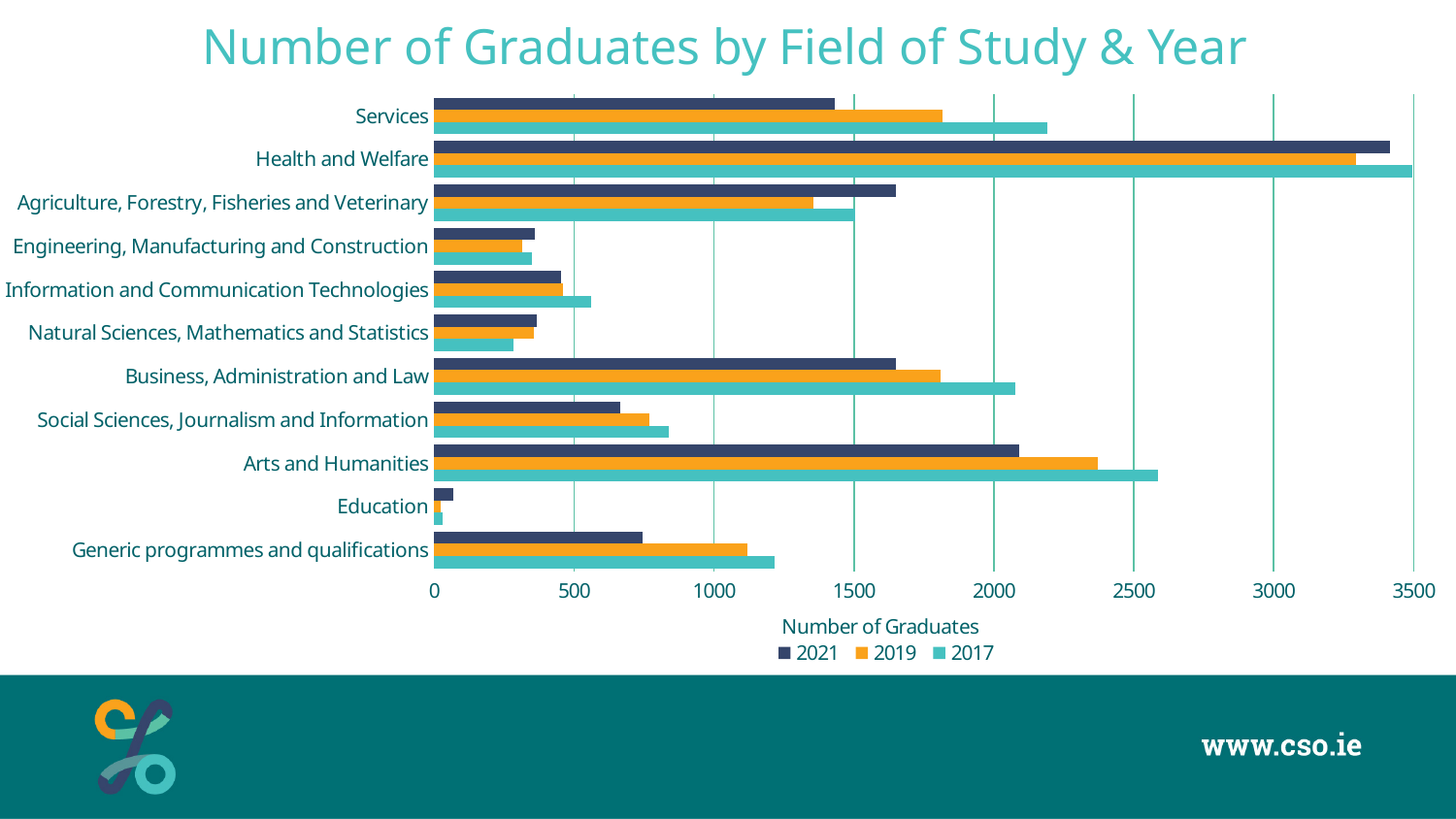
How many series does the legend list? 3 For Services, which year has more graduates, 2021 or 2017? 2017 Is the 2017 value for Services greater or less than 2000? greater Is the 2021 value for Social Sciences, Journalism and Information greater or less than 1000? less Is the 2019 value for Arts and Humanities greater or less than 2500? less For Generic programmes and qualifications, which year has more graduates, 2019 or 2021? 2019 Which field of study has the highest number of graduates in 2021? Health and Welfare Which colour represents 2019 in the legend? Orange How many fields of study are shown on the chart? 11 What type of chart is shown on the slide? Bar chart Which field of study has the lowest number of graduates in 2017? Education What is the title of the horizontal axis? Number of Graduates